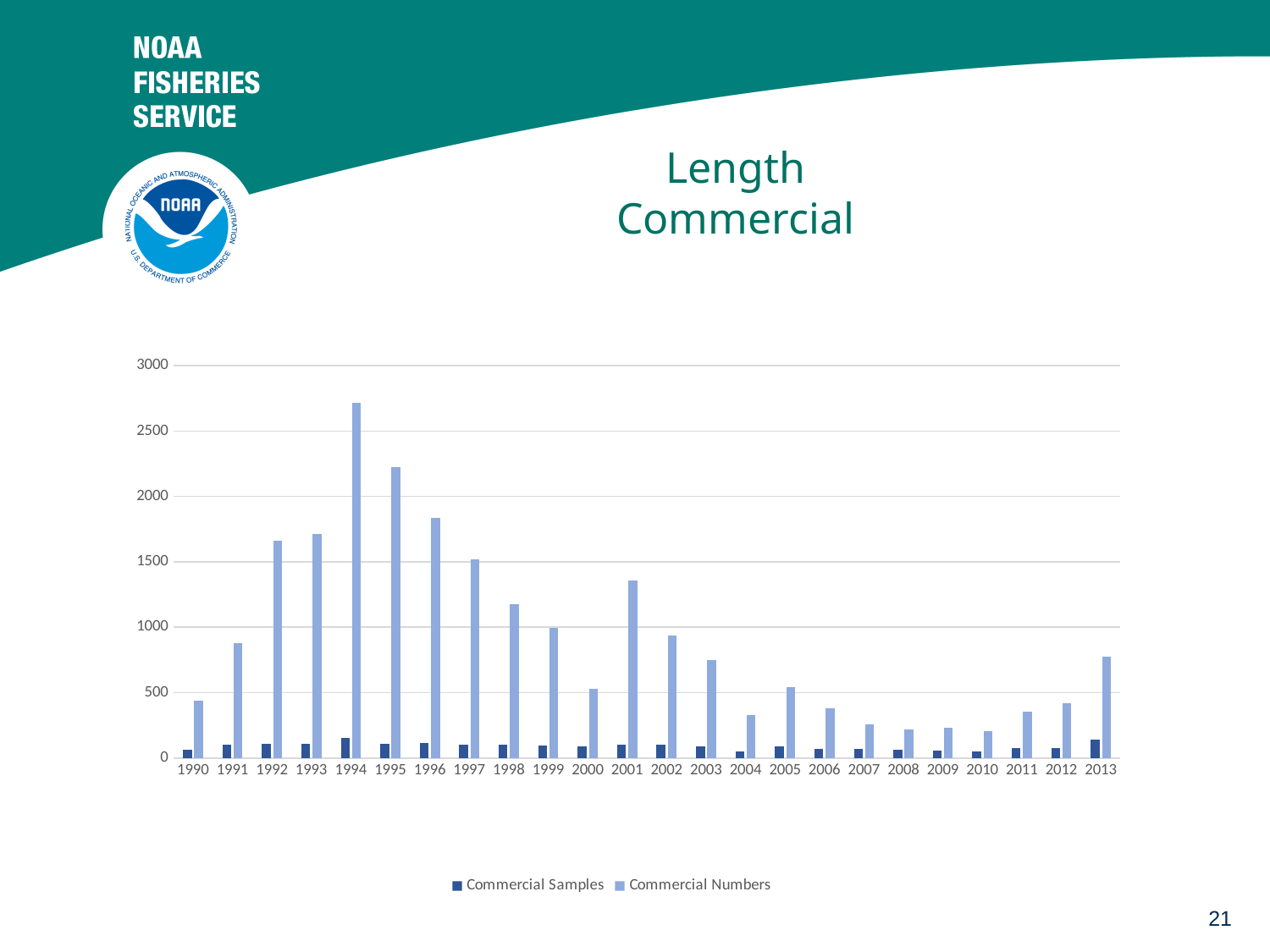
What is the title of the slide containing the chart? Length Commercial Is the Commercial Numbers value for 2001 greater or less than 1000? greater What kind of chart is shown on the slide? bar chart Is the Commercial Numbers value for 1990 greater or less than 500? less Which year has the highest value for Commercial Numbers? 1994 Which year has the larger Commercial Numbers value, 2001 or 2002? 2001 How many series does the legend list? 2 Which year has the larger Commercial Numbers value, 1995 or 1996? 1995 How many years are shown on the x axis? 24 Is the Commercial Numbers value for 1994 greater or less than 2500? greater